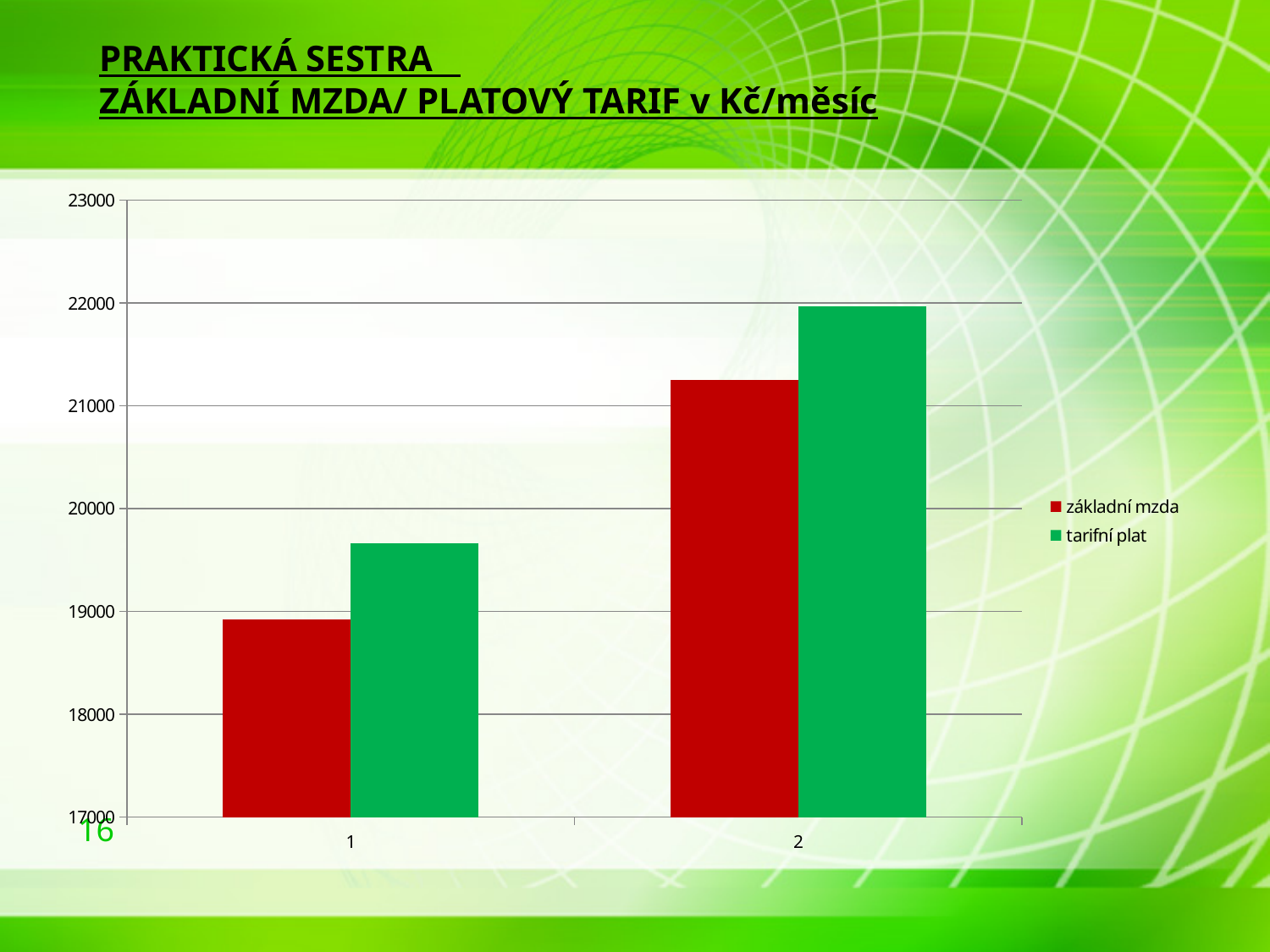
How many categories are shown on the x axis? 2 Is the value of základní mzda for category 1 greater or less than 20000? less Which bar is the highest in the chart? tarifní plat for category 2 What kind of chart is shown on the slide? bar chart How many series does the legend list? 2 Which series is shown in green in the legend? tarifní plat Which series is shown in red in the legend? základní mzda Is the value of tarifní plat for category 2 greater or less than 21000? greater Is the value of základní mzda for category 2 greater or less than 21000? greater Do the values of základní mzda rise or fall from category 1 to category 2? rise For category 1, which is larger: základní mzda or tarifní plat? tarifní plat